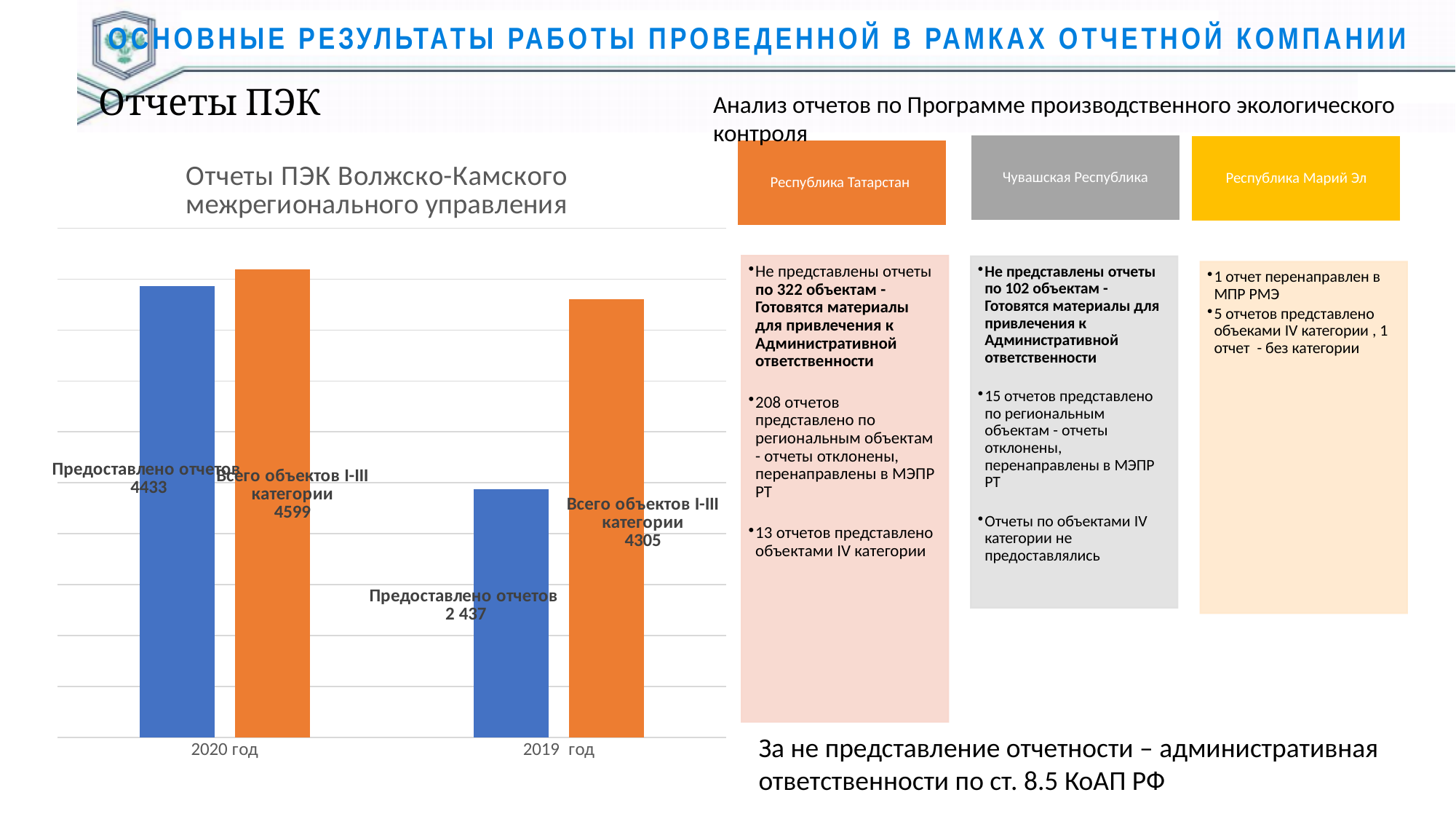
What is the value of "Всего объектов I-III категории" for 2019 год? 4305 Which bar in the chart has the highest value? Всего объектов I-III категории, 2020 год (4599) How many year categories are shown on the x axis of the chart? 2 What is the title of the chart? Отчеты ПЭК Волжско-Камского межрегионального управления What is the difference between "Всего объектов I-III категории" and "Предоставлено отчетов" for 2019 год? 1868 Which is larger: "Предоставлено отчетов" for 2020 год or for 2019 год? 2020 год What is the value of "Всего объектов I-III категории" for 2020 год? 4599 What is the difference between "Всего объектов I-III категории" for 2020 год and 2019 год? 294 What is the value of "Предоставлено отчетов" for 2020 год? 4433 What type of chart is shown on the slide? bar chart Which bar in the chart has the lowest value? Предоставлено отчетов, 2019 год (2 437) What is the value of "Предоставлено отчетов" for 2019 год? 2 437